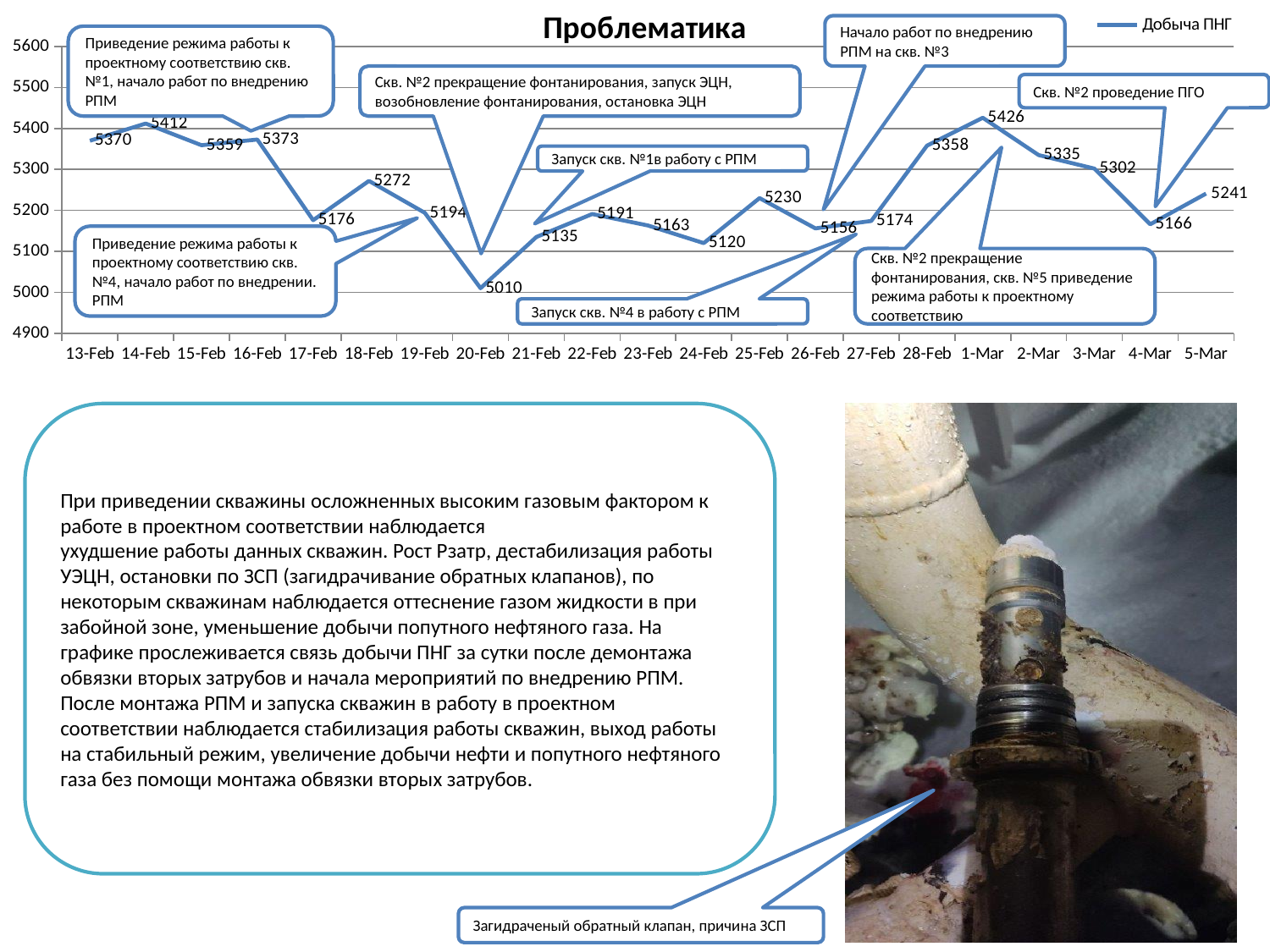
What kind of chart is shown on the slide? line chart On which date is Добыча ПНГ lowest? 20-Feb What is the name of the series shown in the legend? Добыча ПНГ Which is larger, the value on 25-Feb or the value on 26-Feb? 25-Feb Is the value on 4-Mar greater or less than 5200? less What is the value of Добыча ПНГ on 20-Feb? 5010 On which date is Добыча ПНГ highest? 1-Mar What is the value of Добыча ПНГ on 1-Mar? 5426 What is the difference between the values on 14-Feb and 17-Feb? 236 What is the value of Добыча ПНГ on 13-Feb? 5370 What is the difference between the values on 1-Mar and 20-Feb? 416 How many dates are plotted on the x axis? 21